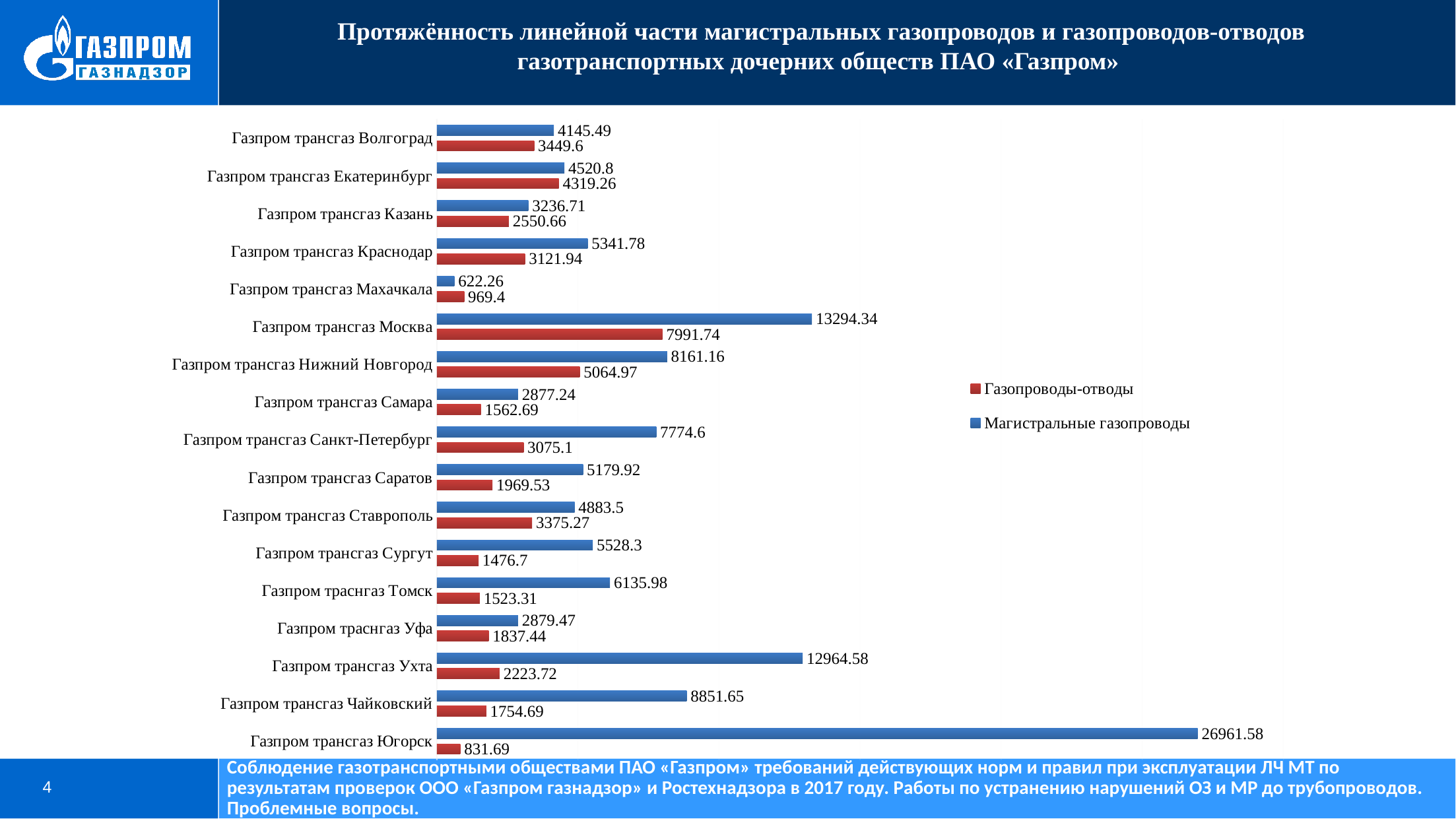
What is the value of Магистральные газопроводы for Газпром трансгаз Ухта? 12964.58 For Газпром трансгаз Махачкала, which is larger: Магистральные газопроводы or Газопроводы-отводы? Газопроводы-отводы How many companies are shown in the chart? 17 Which company has the highest value for Газопроводы-отводы? Газпром трансгаз Москва What type of chart is shown on the slide? Bar chart Which company has the lowest value for Магистральные газопроводы? Газпром трансгаз Махачкала What is the value of Магистральные газопроводы for Газпром трансгаз Москва? 13294.34 How many series does the legend list? 2 What is the value of Газопроводы-отводы for Газпром трансгаз Сургут? 1476.7 What is the difference between Магистральные газопроводы and Газопроводы-отводы for Газпром трансгаз Москва? 5302.6 Which company has the lowest value for Газопроводы-отводы? Газпром трансгаз Югорск Which company has the highest value for Магистральные газопроводы? Газпром трансгаз Югорск